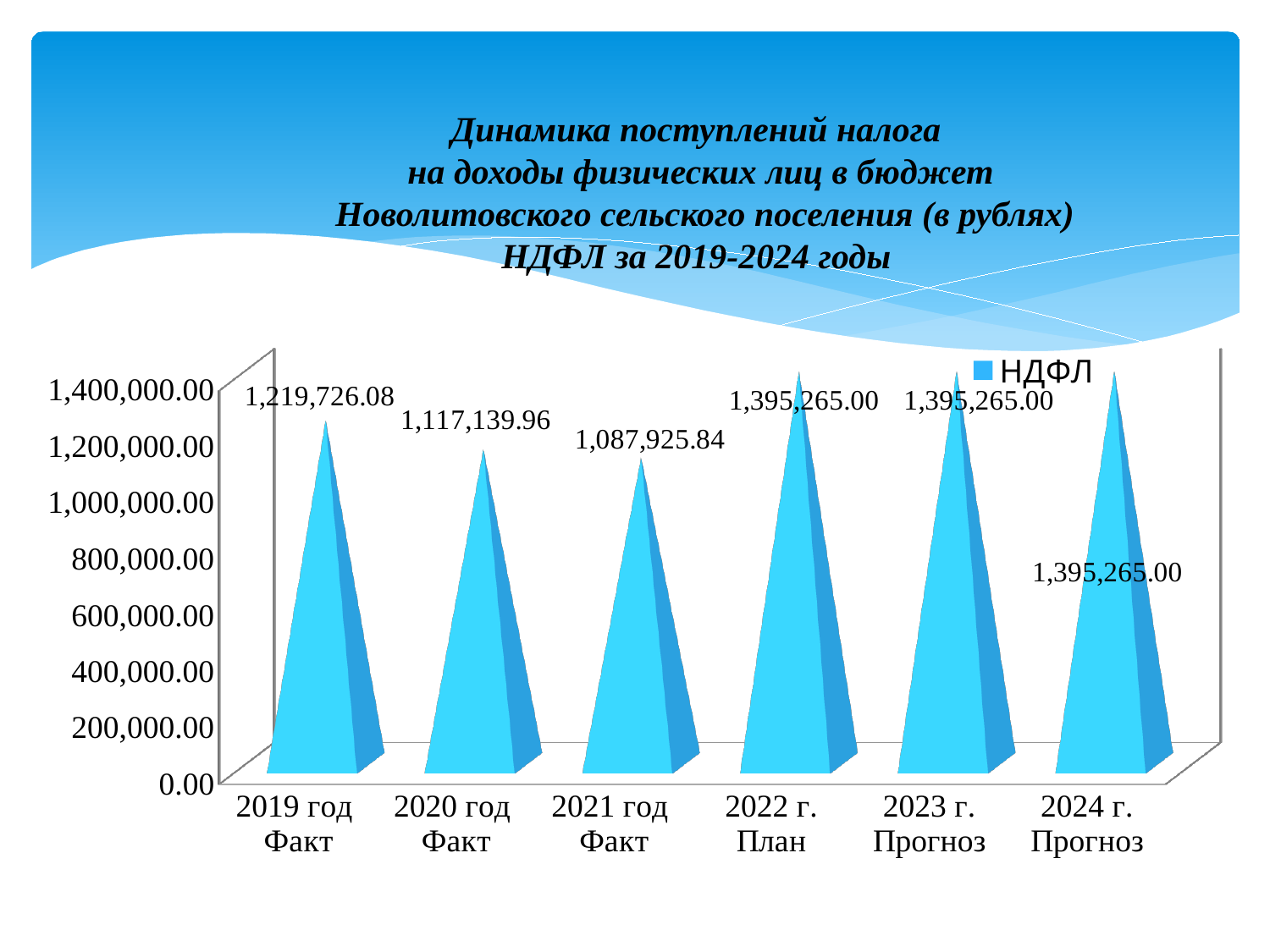
What is the value for 2022 г. План? 1,395,265.00 Is the value for 2021 год Факт greater or less than 1,200,000.00? less How many series does the legend list? 1 Which category has the lowest value? 2021 год Факт What is the value for 2021 год Факт? 1,087,925.84 What is the value for 2019 год Факт? 1,219,726.08 What is the difference between the values for 2022 г. План and 2021 год Факт? 307,339.16 Which is larger, the value for 2019 год Факт or the value for 2020 год Факт? 2019 год Факт What is the difference between the values for 2019 год Факт and 2020 год Факт? 102,586.12 What is the value for 2020 год Факт? 1,117,139.96 Do the values rise or fall from 2019 год Факт to 2021 год Факт? fall How many categories are shown on the x axis? 6